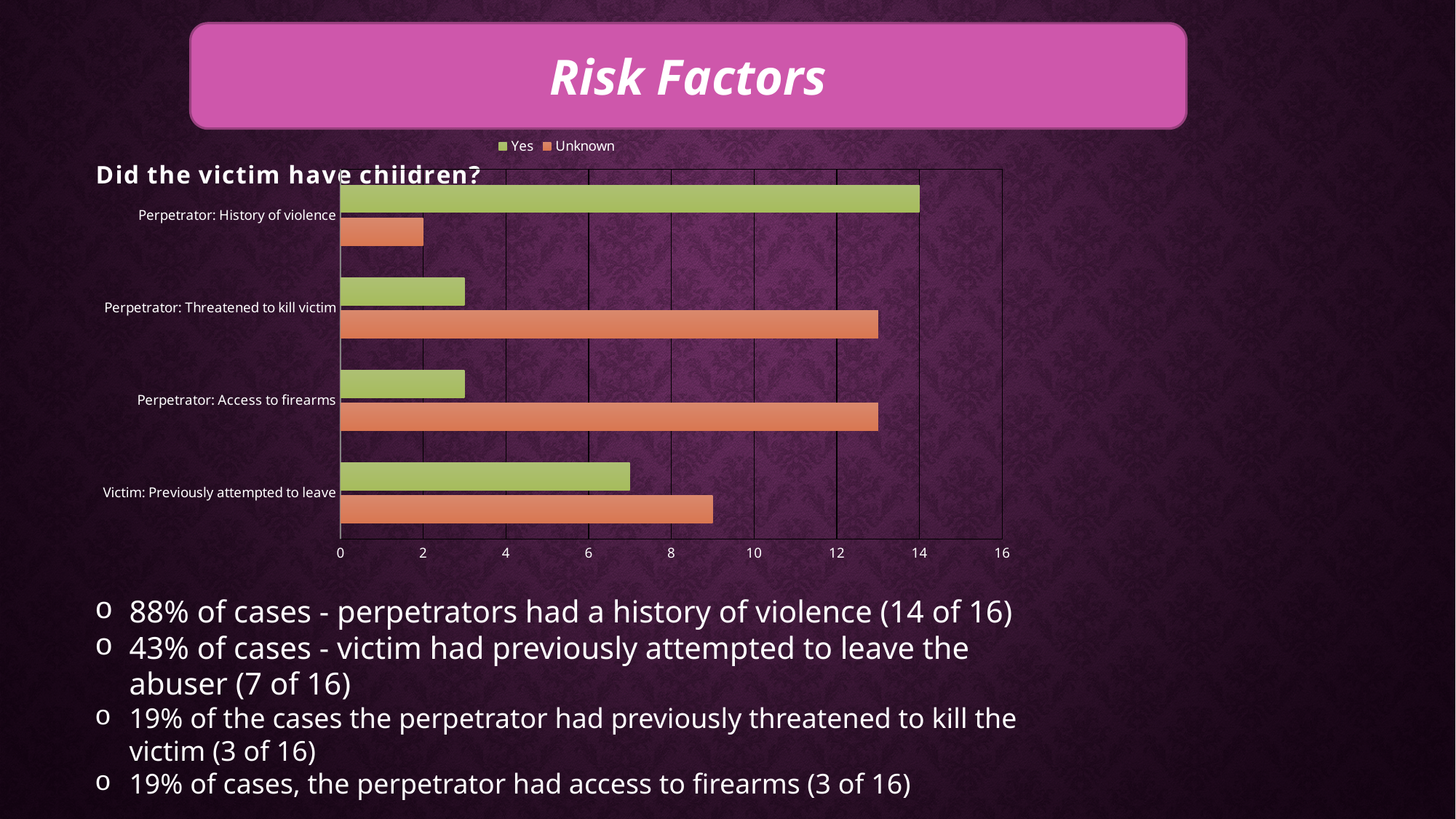
How many categories are plotted on the chart? 4 Which category has the lowest Unknown value? Perpetrator: History of violence What is the difference between the Yes and Unknown values for Perpetrator: History of violence? 12 How many series does the chart legend list? 2 Which category has the highest Yes value? Perpetrator: History of violence Is the Yes value for Perpetrator: Access to firearms greater or less than 4? less Is the Unknown value for Perpetrator: Threatened to kill victim greater or less than 12? greater What are the two entries in the chart legend? Yes and Unknown For Victim: Previously attempted to leave, which is larger, the Yes value or the Unknown value? Unknown What kind of chart is shown on the slide? bar chart What is the Unknown value for Perpetrator: History of violence? 2 What is the Yes value for Perpetrator: History of violence? 14